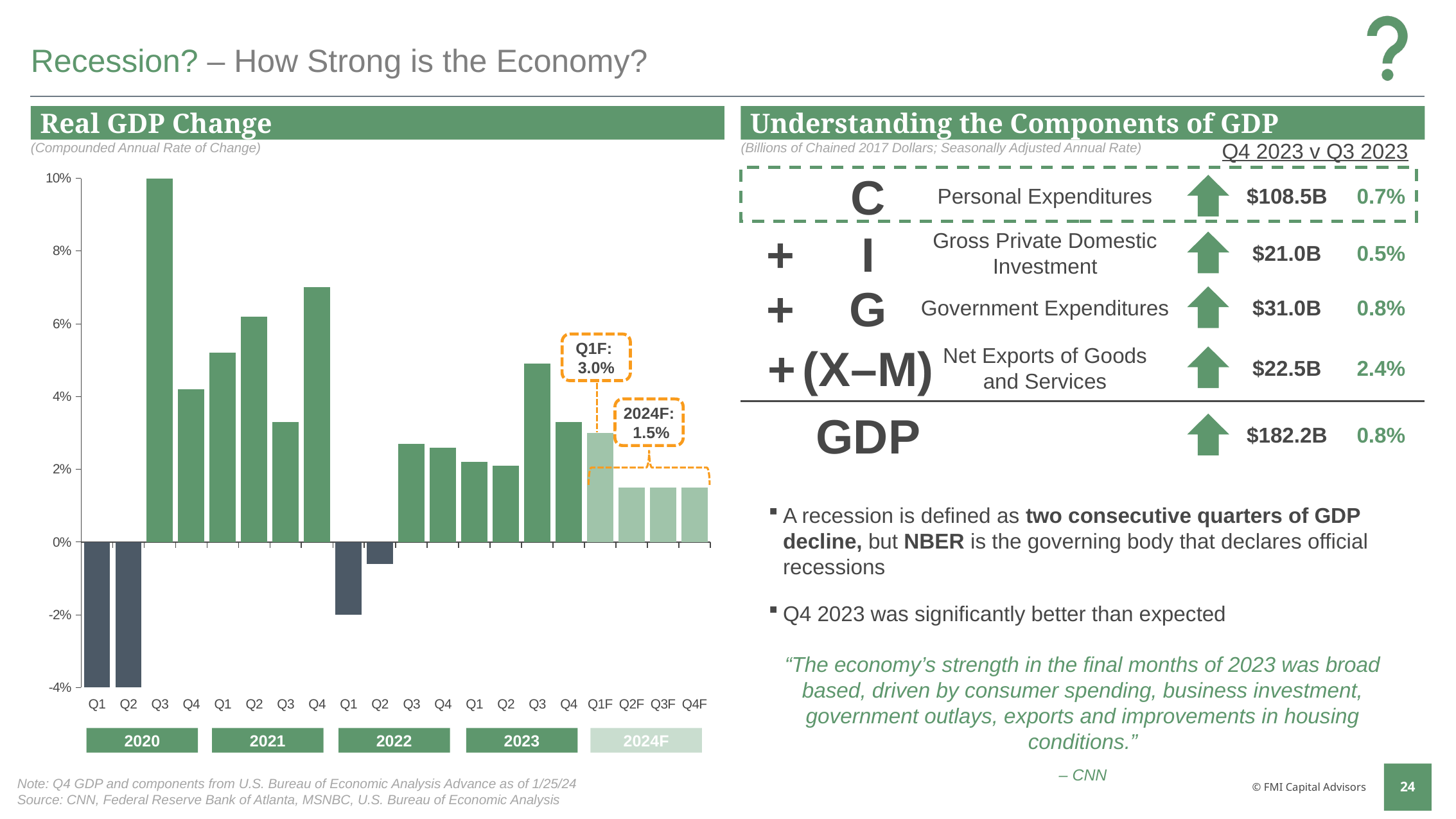
In the Real GDP Change chart, is the value for Q4 2023 greater or less than 4%? less In the Real GDP Change chart, which is larger, the value for Q3 2023 or Q4 2023? Q3 2023 In the Real GDP Change chart, is the value for Q1 2022 greater or less than 0%? less In the Real GDP Change chart, is the value for Q4 2021 greater or less than 6%? greater What kind of chart is the Real GDP Change chart? Bar chart In the Real GDP Change chart, which quarter has the highest bar? Q3 2020 How many quarterly bars are plotted in the Real GDP Change chart? 20 In the Real GDP Change chart, what is the forecast value shown for Q2F, Q3F and Q4F of 2024? 1.5% In the Real GDP Change chart, what is the forecast value for Q1F 2024? 3.0% In the Real GDP Change chart, do the values rise or fall from Q1 2022 to Q3 2022? rise In the Real GDP Change chart, how many quarters show a negative value? 4 In the Real GDP Change chart, how much higher is the Q1F 2024 forecast than the Q2F 2024 forecast? 1.5%